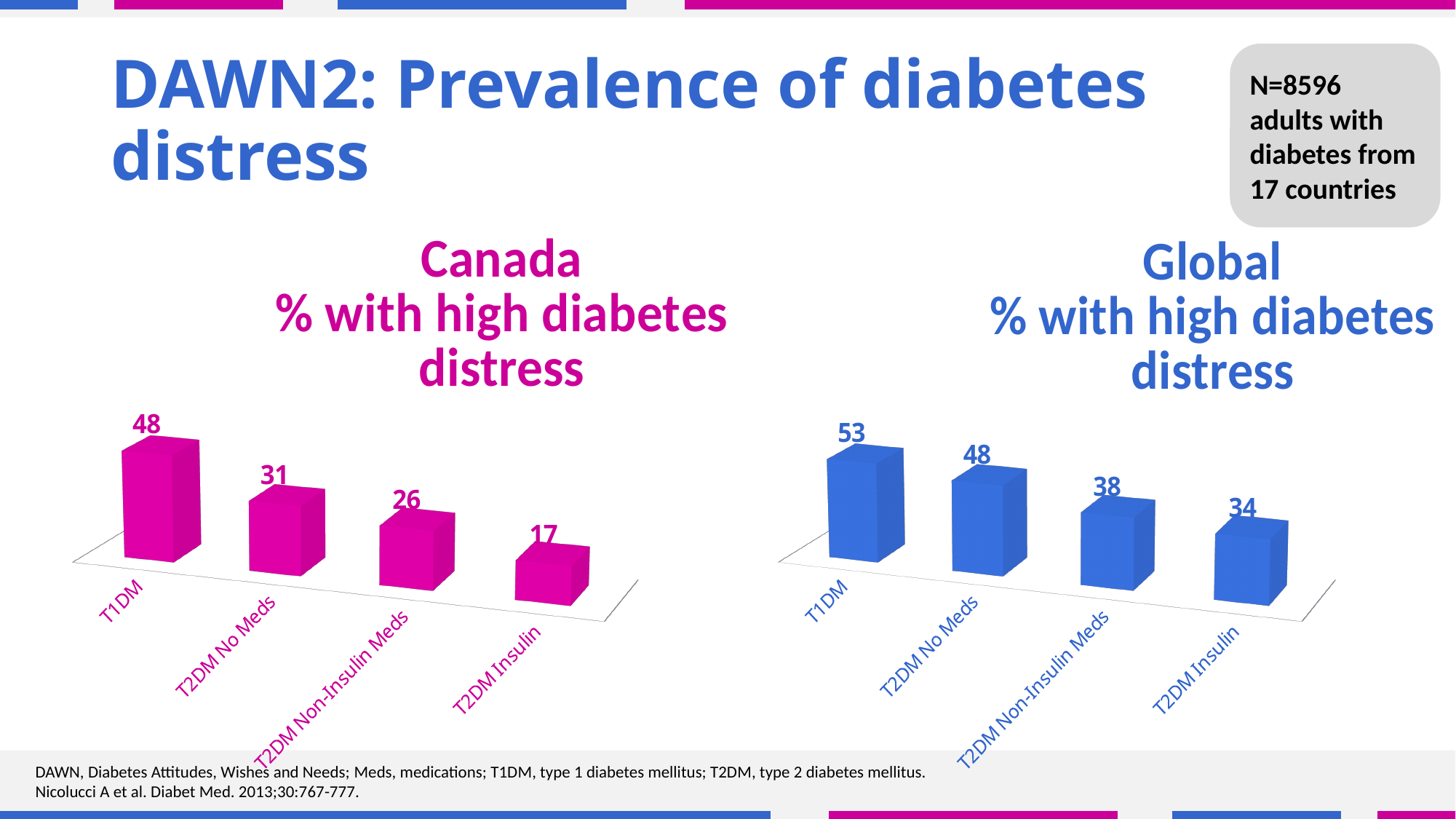
In the Canada chart, what is the difference between the values for T2DM No Meds and T2DM Non-Insulin Meds? 5 In the Global chart, which category has the highest value? T1DM In the Canada chart, which category has the lowest value? T2DM Insulin In the Global chart, what is the value for T2DM Non-Insulin Meds? 38 In the Global chart, what is the difference between the values for T1DM and T2DM Insulin? 19 In the Canada chart, what is the value for T1DM? 48 What kind of chart is the Global chart? Bar chart In the Canada chart, what is the value for T2DM Insulin? 17 How many categories are shown in the Canada chart? 4 Which is larger: the value for T2DM No Meds in the Canada chart or in the Global chart? Global In the Global chart, do the values rise or fall from T1DM to T2DM Insulin? Fall What colour are the bars in the Canada chart? Magenta (pink)